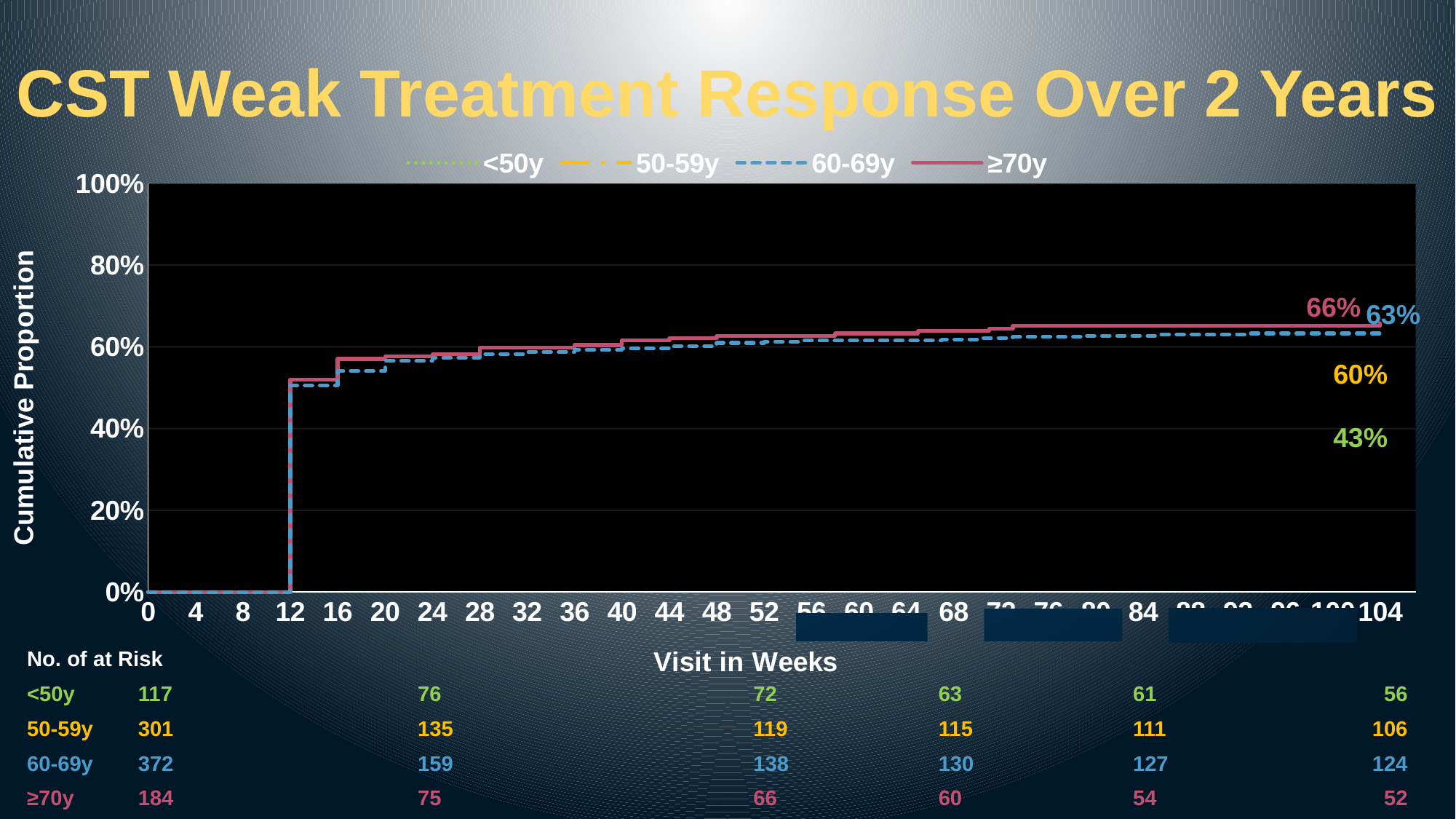
What is the difference between the labelled cumulative proportions for the ≥70y and <50y groups? 23% Which is larger, the labelled cumulative proportion for 60-69y or for 50-59y? 60-69y What is the cumulative proportion labelled for the 50-59y group? 60% What is the title of the chart? CST Weak Treatment Response Over 2 Years What is the cumulative proportion labelled for the <50y group? 43% What is the cumulative proportion labelled at the end of the curve for the 60-69y group? 63% Which age group has the highest labelled cumulative proportion? ≥70y Which age group has the lowest labelled cumulative proportion? <50y Does the cumulative proportion for the ≥70y group rise or fall as the visit weeks increase? rise What is the cumulative proportion labelled at the end of the curve for the ≥70y group? 66% How many series does the legend list? 4 What kind of chart is shown on the slide? line chart